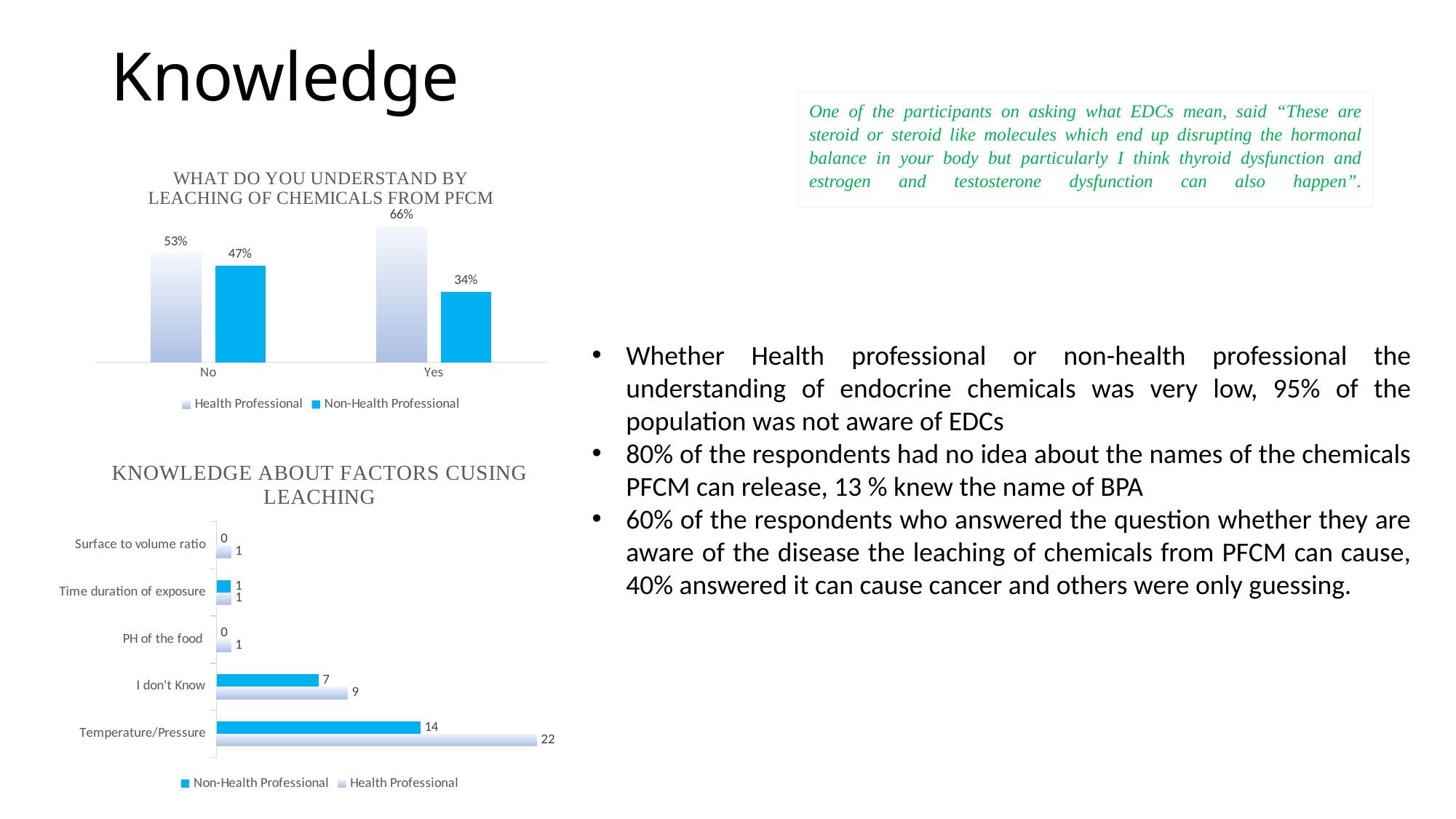
What kind of chart is the one titled 'KNOWLEDGE ABOUT FACTORS CUSING LEACHING'? Bar chart In the chart titled 'KNOWLEDGE ABOUT FACTORS CUSING LEACHING', what is the Health Professional value for Temperature/Pressure? 22 In the chart titled 'KNOWLEDGE ABOUT FACTORS CUSING LEACHING', what is the Non-Health Professional value for 'PH of the food'? 0 In the chart titled 'WHAT DO YOU UNDERSTAND BY LEACHING OF CHEMICALS FROM PFCM', what is the value for Non-Health Professional in the 'No' category? 47% In the chart titled 'KNOWLEDGE ABOUT FACTORS CUSING LEACHING', which category has the highest Health Professional value? Temperature/Pressure In the chart titled 'WHAT DO YOU UNDERSTAND BY LEACHING OF CHEMICALS FROM PFCM', what is the difference between the Health Professional and Non-Health Professional values in the 'Yes' category? 32% In the chart titled 'KNOWLEDGE ABOUT FACTORS CUSING LEACHING', how many categories are shown? 5 In the chart titled 'WHAT DO YOU UNDERSTAND BY LEACHING OF CHEMICALS FROM PFCM', which series has the larger value in the 'No' category? Health Professional In the chart titled 'WHAT DO YOU UNDERSTAND BY LEACHING OF CHEMICALS FROM PFCM', what is the value for Health Professional in the 'Yes' category? 66% In the chart titled 'KNOWLEDGE ABOUT FACTORS CUSING LEACHING', what is the difference between the Health Professional and Non-Health Professional values for Temperature/Pressure? 8 In the chart titled 'WHAT DO YOU UNDERSTAND BY LEACHING OF CHEMICALS FROM PFCM', how many series does the legend list? 2 In the chart titled 'KNOWLEDGE ABOUT FACTORS CUSING LEACHING', what is the Non-Health Professional value for 'I don't Know'? 7